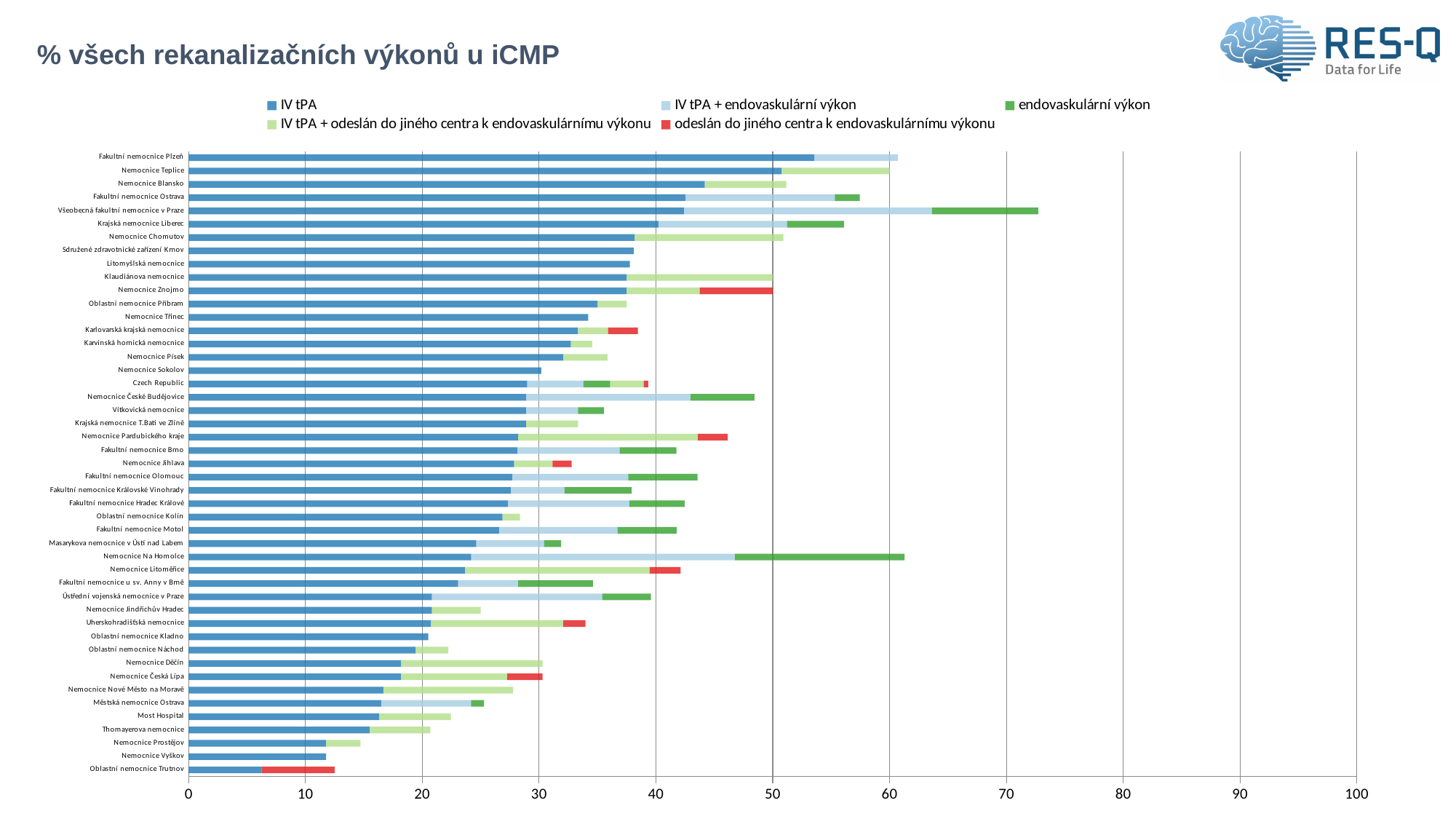
Which hospital has the longest total stacked bar? Všeobecná fakultní nemocnice v Praze Do the IV tPA values rise or fall going from the top of the chart to the bottom? fall Is the total bar for Nemocnice Na Homolce greater or less than 60? greater Is the IV tPA value for Oblastní nemocnice Trutnov greater or less than 10? less Which hospital has the longest IV tPA (dark blue) segment? Fakultní nemocnice Plzeň How many series does the legend list? 5 Which has a larger IV tPA value, Nemocnice Teplice or Nemocnice Vyškov? Nemocnice Teplice Which hospital has the shortest IV tPA (dark blue) segment? Oblastní nemocnice Trutnov Is the IV tPA value for Fakultní nemocnice Plzeň greater or less than 50? greater What is the title of the chart? % všech rekanalizačních výkonů u iCMP What kind of chart is shown on the slide? Stacked horizontal bar chart Which legend entry is shown in red? odeslán do jiného centra k endovaskulárnímu výkonu